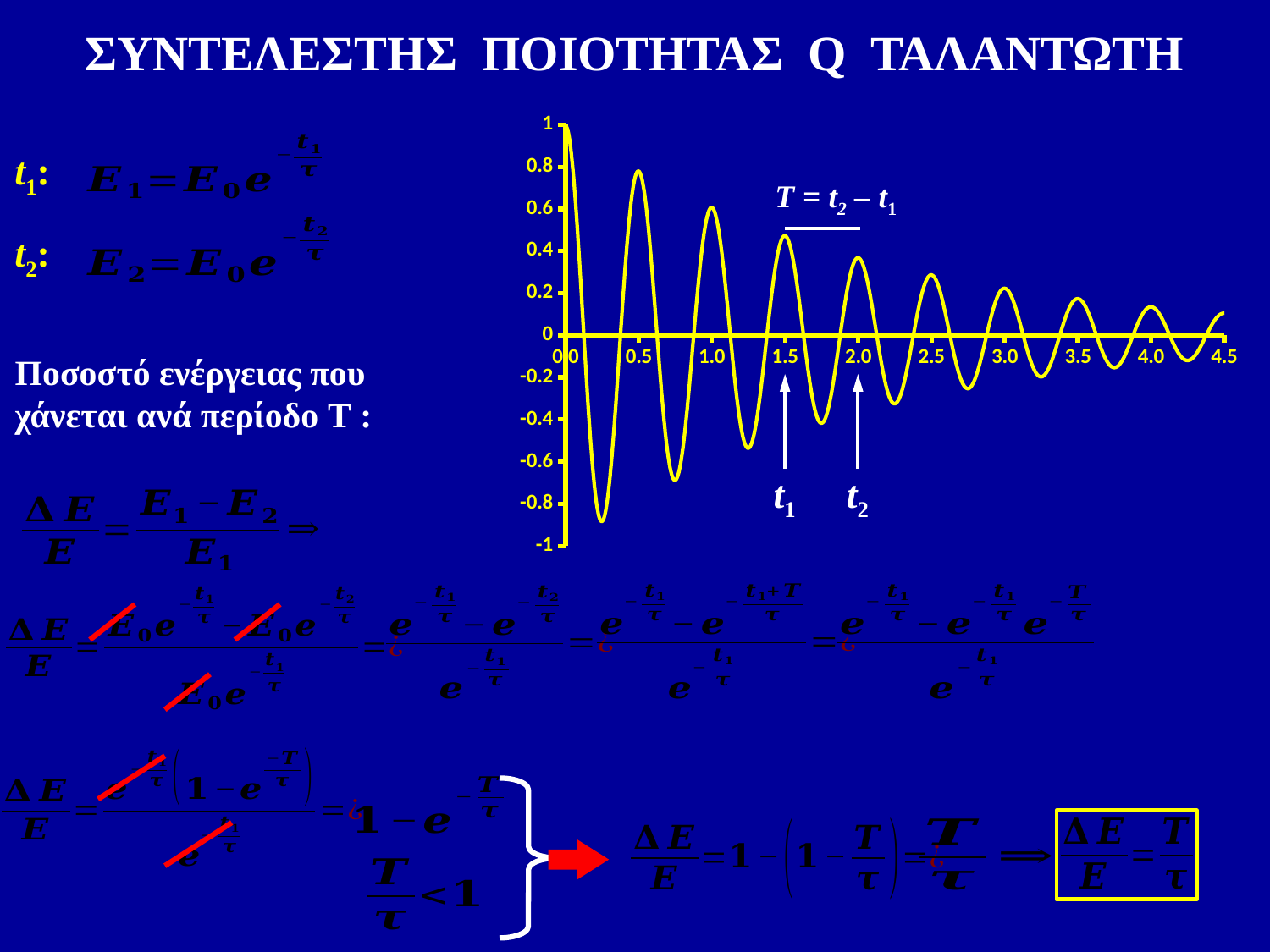
What is the highest value shown on the vertical axis of the chart? 1 Which peak is higher: the one near x = 1.0 or the one near x = 2.0? the one near x = 1.0 Is the peak of the curve near x = 1.0 greater or less than 0.4? greater What is the largest tick value shown on the horizontal axis of the chart? 4.5 Does the amplitude of the oscillation increase or decrease as the x axis value increases? decrease Is the peak of the curve near x = 3.0 greater or less than 0.4? less Which two time points are marked with arrows below the curve on the chart? t1 and t2 What is the lowest value shown on the vertical axis of the chart? -1 How many labelled tick marks are there on the horizontal axis of the chart? 10 What kind of chart is shown on the slide? line chart Is the peak of the curve near x = 1.5 greater or less than 0.6? less